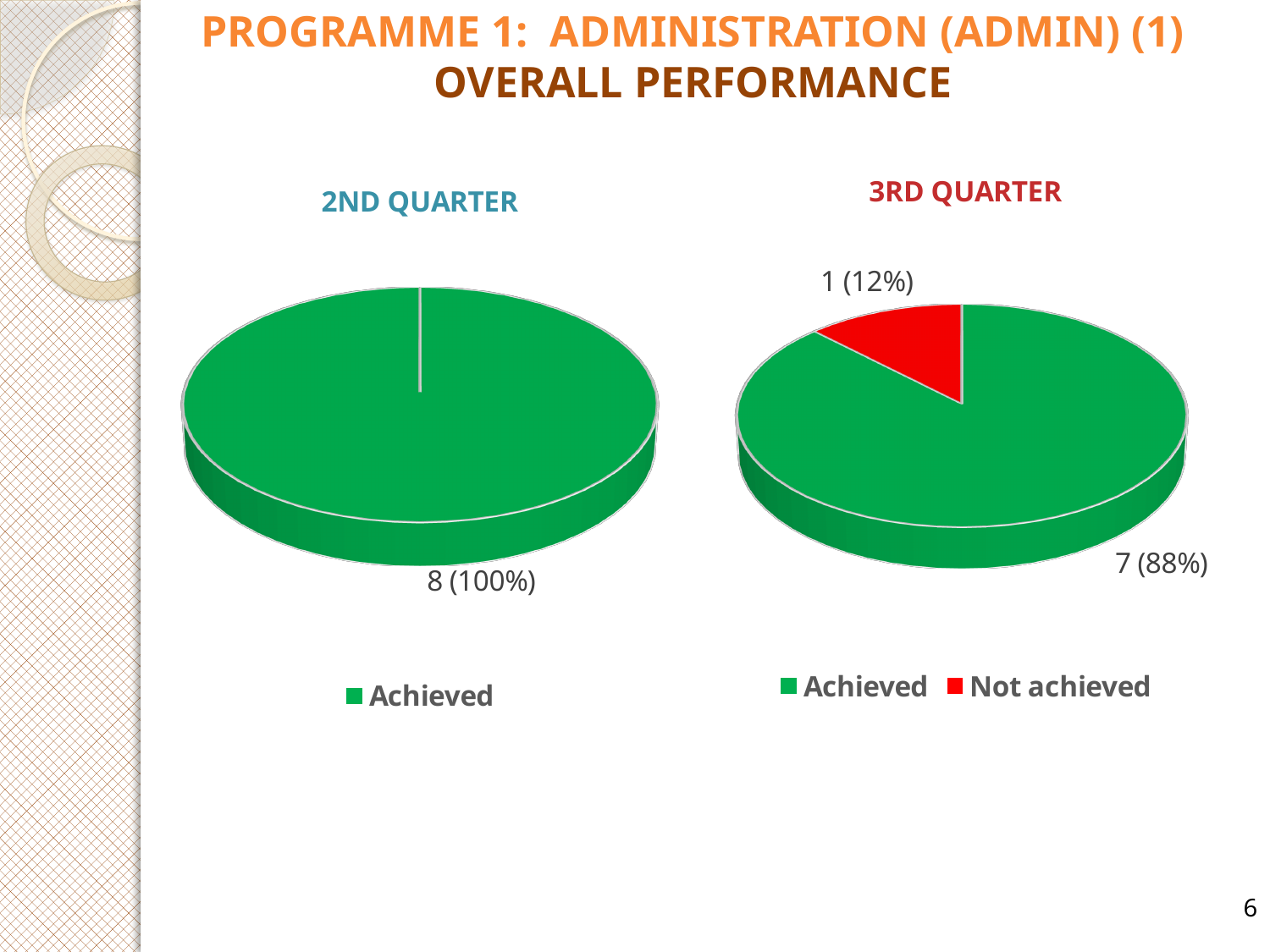
In the 3RD QUARTER chart, what colour is the Not achieved slice? red In the 3RD QUARTER chart, which is larger, Achieved or Not achieved? Achieved In the 3RD QUARTER chart, what is the value for Not achieved? 1 (12%) In the 2ND QUARTER chart, what is the value for Achieved? 8 (100%) In the 3RD QUARTER chart, what is the difference between the Achieved count and the Not achieved count? 6 What kind of chart is the 2ND QUARTER chart? pie chart In the 3RD QUARTER chart, what share of the pie does Not achieved take? 12% In the 3RD QUARTER chart, which category is the smallest? Not achieved How many entries does the legend of the 2ND QUARTER chart list? 1 How many slices does the 3RD QUARTER pie chart have? 2 In the 3RD QUARTER chart, what is the value for Achieved? 7 (88%) In the 3RD QUARTER chart, which category is the largest? Achieved